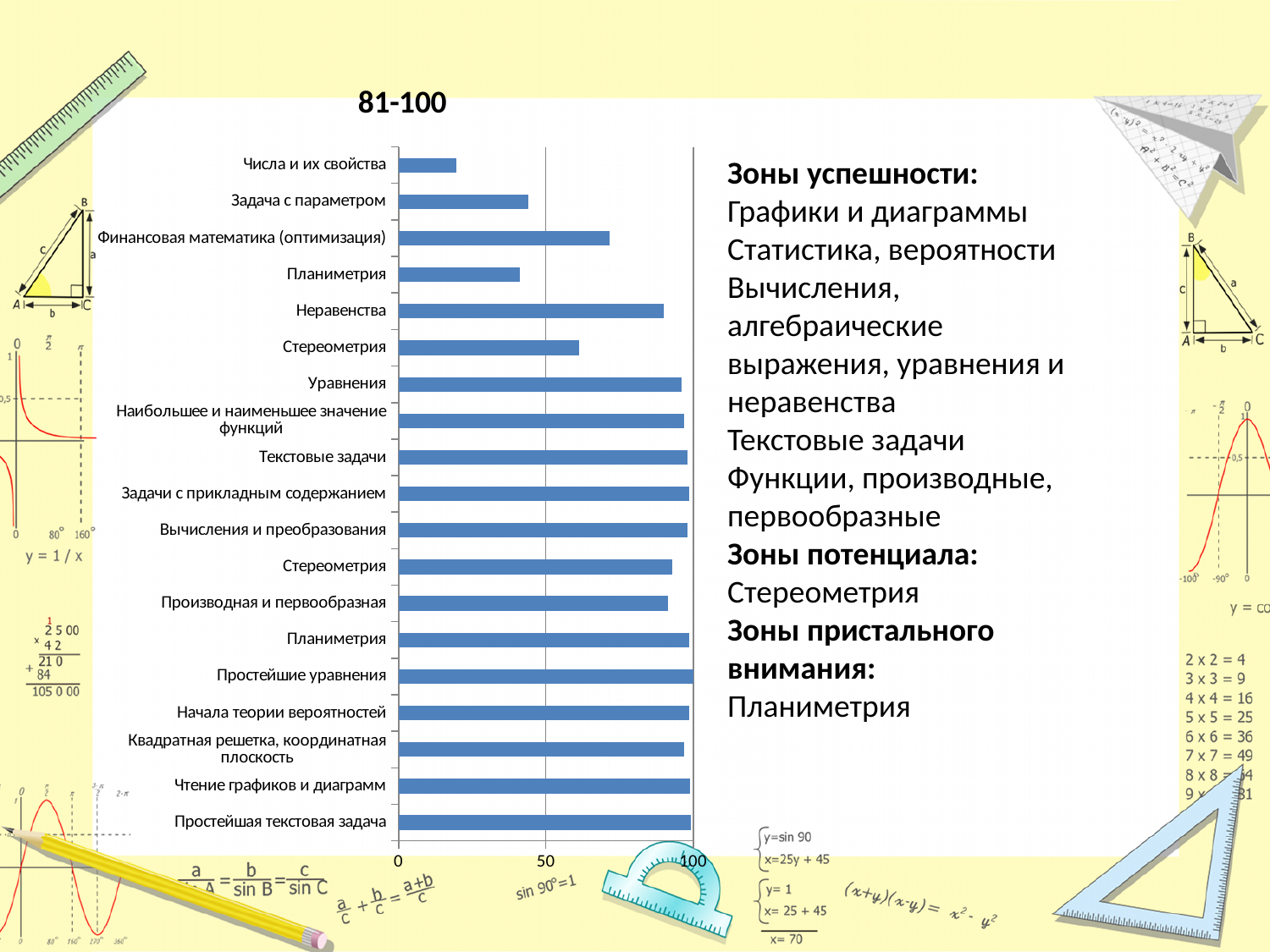
Is the value for Неравенства greater or less than 50? greater Which has a larger value, Неравенства or Числа и их свойства? Неравенства What kind of chart is shown on the slide? bar chart What colour are the bars in the chart? blue Which has a larger value, Финансовая математика (оптимизация) or Задача с параметром? Финансовая математика (оптимизация) Is the value for Числа и их свойства greater or less than 50? less What is the title of the chart? 81-100 Is the value for Уравнения greater or less than 50? greater How many categories are plotted in the chart? 19 Which category has the lowest value in the chart? Числа и их свойства